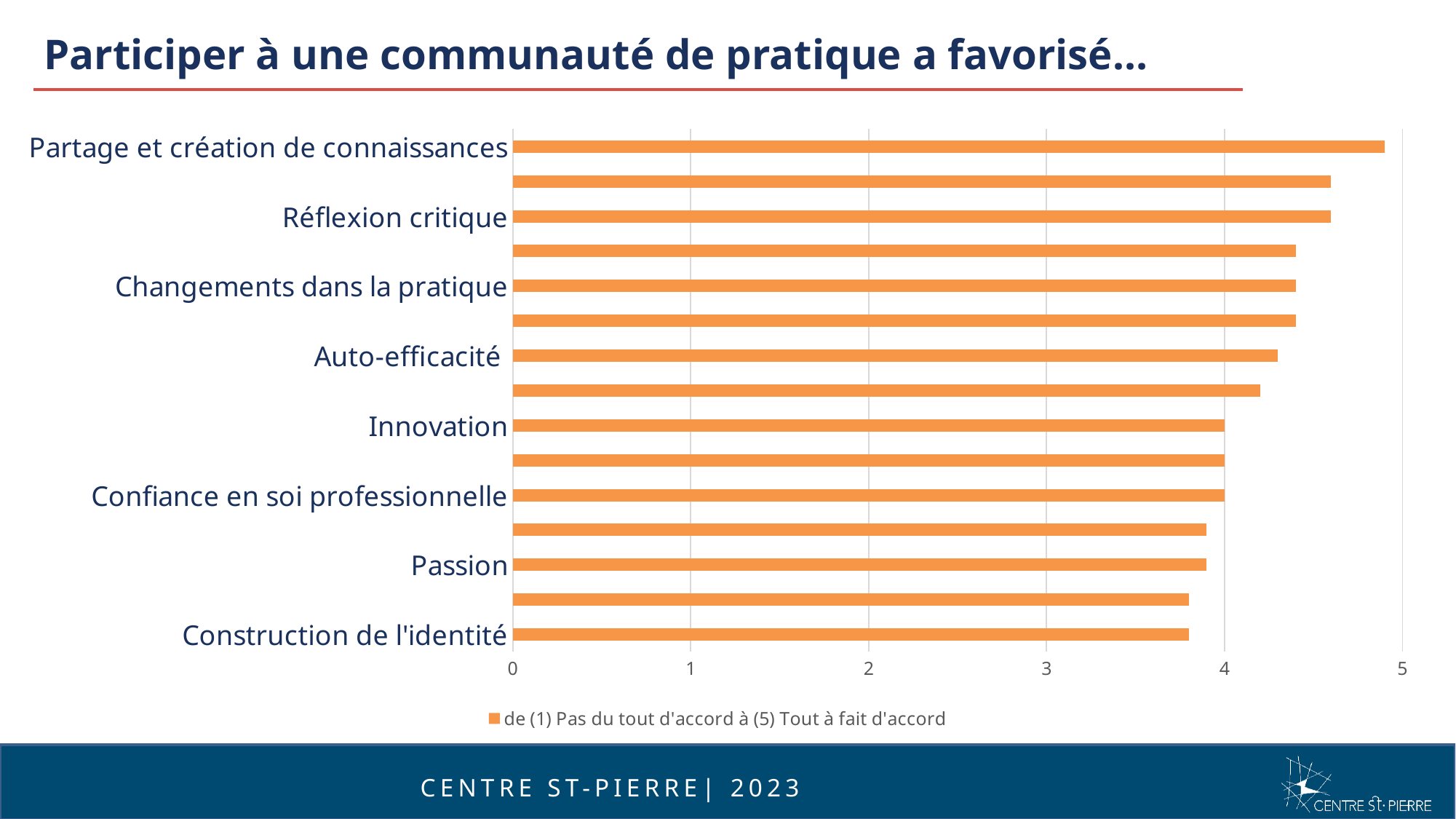
What kind of chart is shown on the slide? Bar chart Which labelled category has the highest value? Partage et création de connaissances What is the legend entry of the chart? de (1) Pas du tout d'accord à (5) Tout à fait d'accord Is the value for Auto-efficacité greater or less than 4? greater Which is larger, the value for Réflexion critique or the value for Construction de l'identité? Réflexion critique Is the value for Partage et création de connaissances greater or less than 4? greater How many series does the legend list? 1 Which is larger, the value for Partage et création de connaissances or the value for Passion? Partage et création de connaissances Is the value for Réflexion critique greater or less than 4? greater Which labelled category has the lowest value? Construction de l'identité Do the bar values increase or decrease going from the top of the chart to the bottom? Decrease